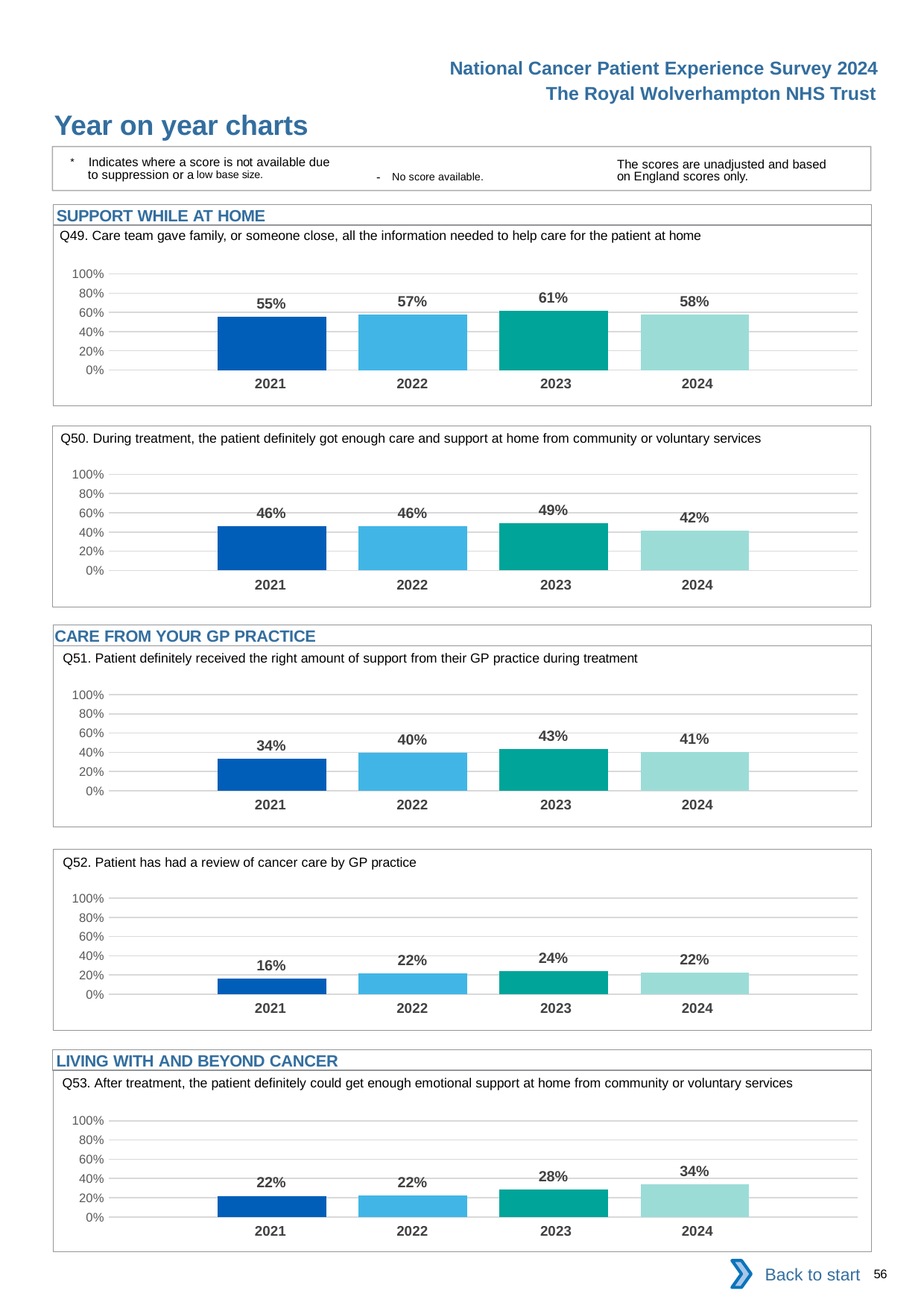
How many years are plotted in the Q50 chart? 4 In the Q52 chart, what is the value for 2021? 16% In the Q50 chart, what is the value for 2022? 46% In the Q49 chart, what is the value for 2023? 61% In the Q49 chart, which is larger, the value for 2022 or the value for 2024? 2024 In the Q51 chart, what is the difference between the 2023 and 2021 values? 9% In the Q50 chart, which year has the lowest value? 2024 In the Q52 chart, what is the difference between the 2023 and 2024 values? 2% In the Q53 chart, which year has the highest value? 2024 In the Q53 chart, do the values rise or fall from 2022 to 2024? rise What kind of chart is the Q52 chart? bar chart In the Q51 chart, is the value for 2021 greater or less than 40%? less